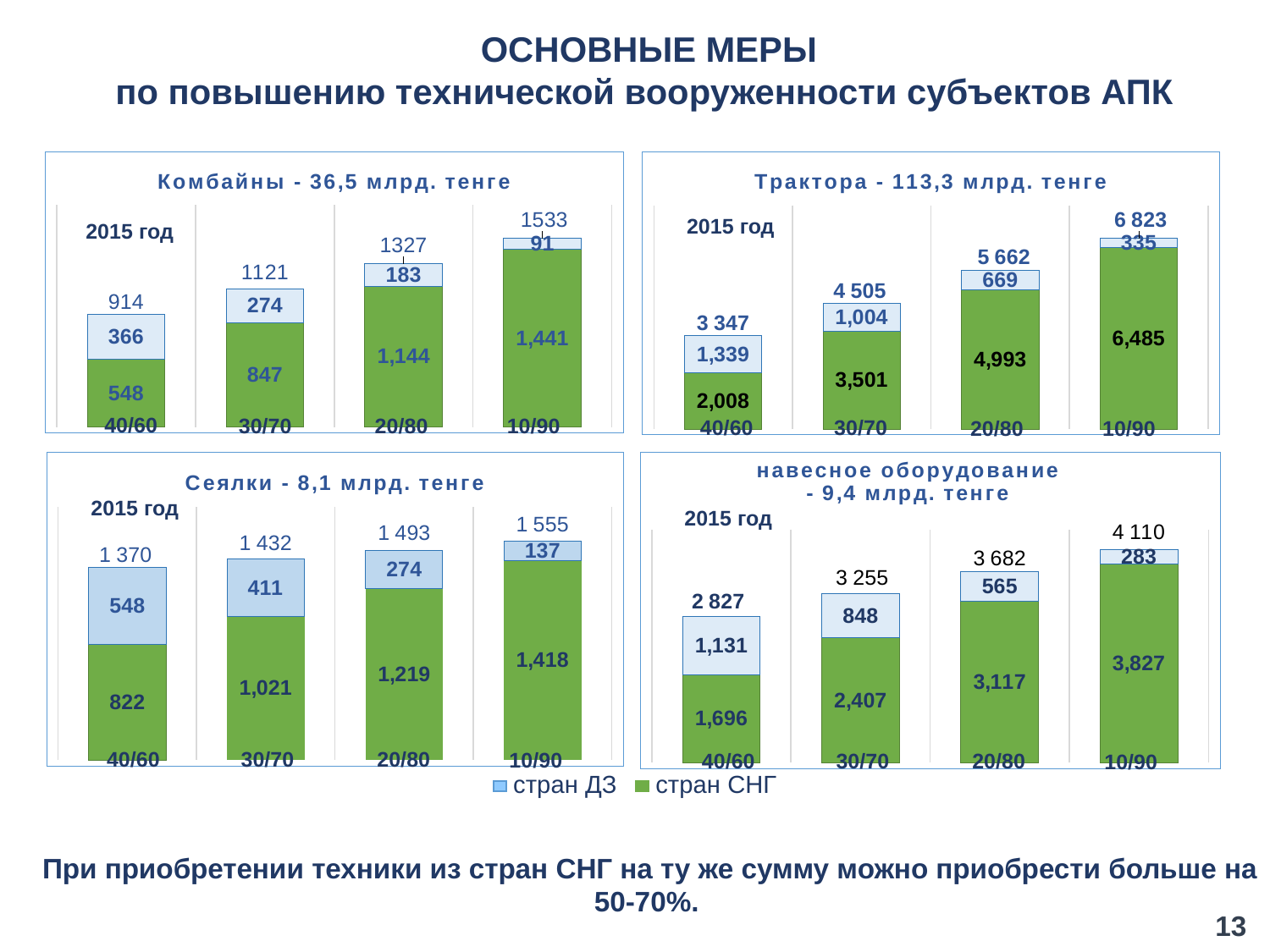
In the chart titled 'Сеялки - 8,1 млрд. тенге', which is larger: the страны ДЗ value for 40/60 or the страны ДЗ value for 20/80? 40/60 How many categories are shown on the x axis of the chart titled 'навесное оборудование - 9,4 млрд. тенге'? 4 In the chart titled 'навесное оборудование - 9,4 млрд. тенге', which category has the highest total? 10/90 In the chart titled 'Комбайны - 36,5 млрд. тенге', do the страны СНГ values rise or fall from 40/60 to 10/90? Rise In the chart titled 'Трактора - 113,3 млрд. тенге', what is the difference between the страны СНГ values for 10/90 and 40/60? 4,477 In the chart titled 'Комбайны - 36,5 млрд. тенге', which category has the lowest value for страны ДЗ? 10/90 In the chart titled 'Комбайны - 36,5 млрд. тенге', what is the value for страны СНГ in the 30/70 category? 847 What kind of chart is the chart titled 'Трактора - 113,3 млрд. тенге'? Stacked bar chart How many series does the legend at the bottom of the slide list? 2 Which series in the legend is shown in green? страны СНГ In the chart titled 'Сеялки - 8,1 млрд. тенге', what is the total of the stacked bar for 10/90? 1 555 In the chart titled 'Трактора - 113,3 млрд. тенге', what is the value for страны ДЗ in the 20/80 category? 669